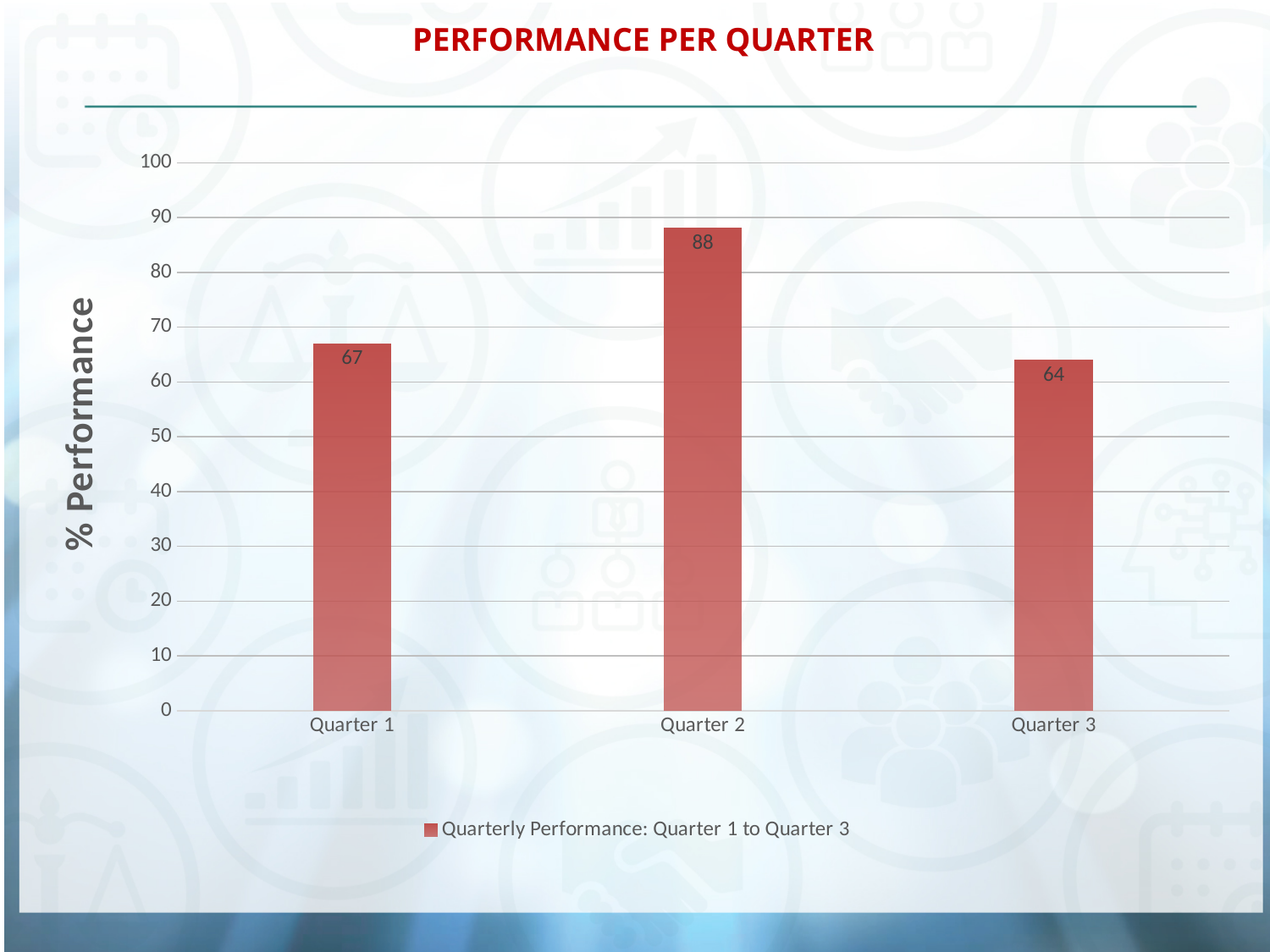
What is the value for Quarter 3? 64 What is the difference between the values for Quarter 2 and Quarter 1? 21 What is the value for Quarter 2? 88 Which quarter has the lowest performance? Quarter 3 Which quarter has the highest performance? Quarter 2 What is the difference between the values for Quarter 1 and Quarter 3? 3 What is the label on the y axis? % Performance What is the value for Quarter 1? 67 What kind of chart is shown on the slide? Bar chart How many quarters are shown on the x axis? 3 Which is larger, the value for Quarter 2 or the value for Quarter 3? Quarter 2 Is the value for Quarter 2 greater or less than 80? greater